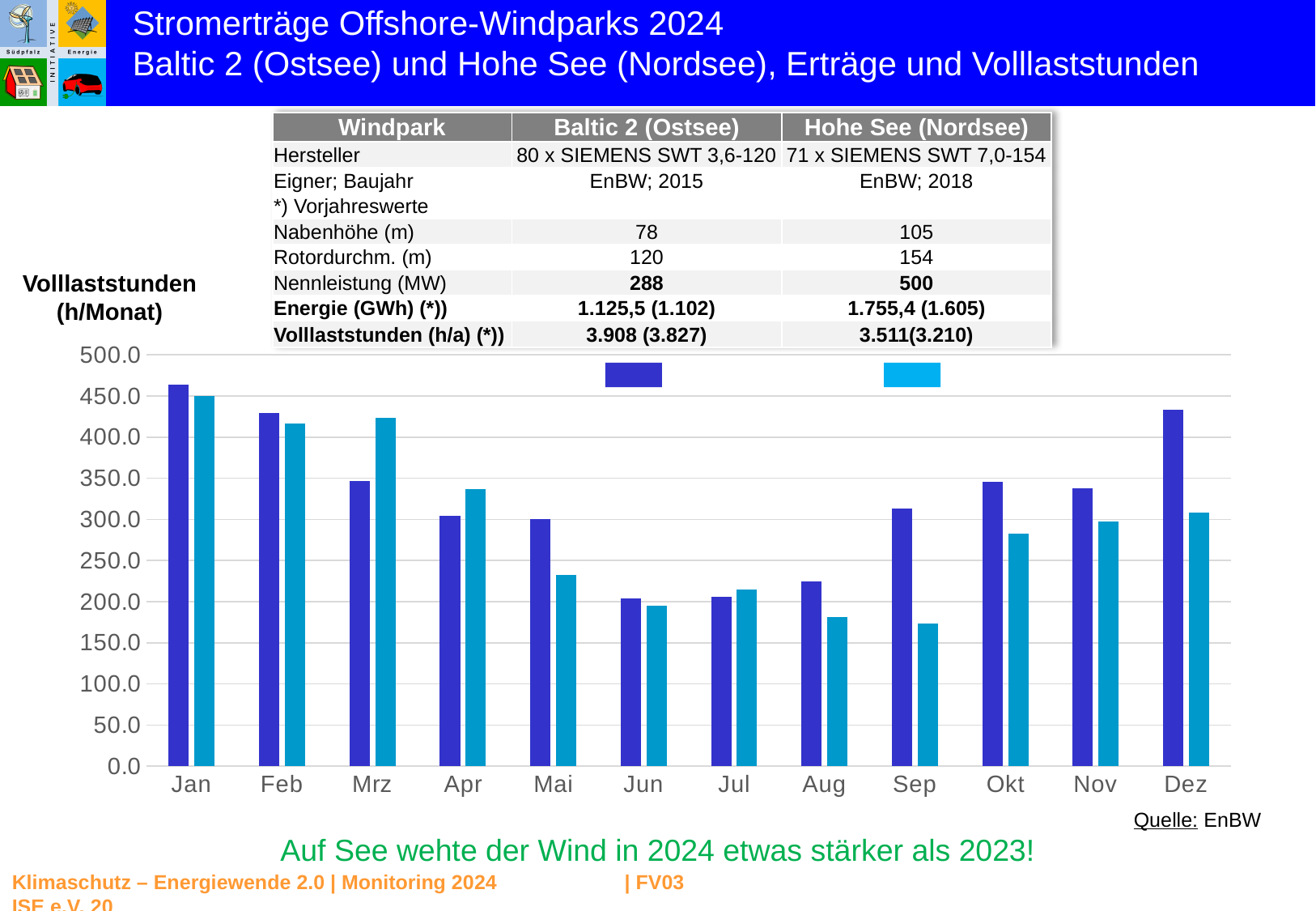
How many months (categories) are shown on the x axis of the chart? 12 How many series (bar colours) does the chart's legend show? 2 Is the light blue value for Mrz greater or less than 400? greater In which month is the light blue bar the highest? Jan Is the dark blue value for Jun greater or less than 250? less Do the dark blue values rise or fall from Jan to Jun? fall In Sep, which bar is taller, the dark blue or the light blue one? dark blue Is the dark blue value for Jan greater or less than 450? greater In which month is the dark blue bar the highest? Jan In Mrz, which bar is taller, the dark blue or the light blue one? light blue What kind of chart is shown on the slide? bar chart